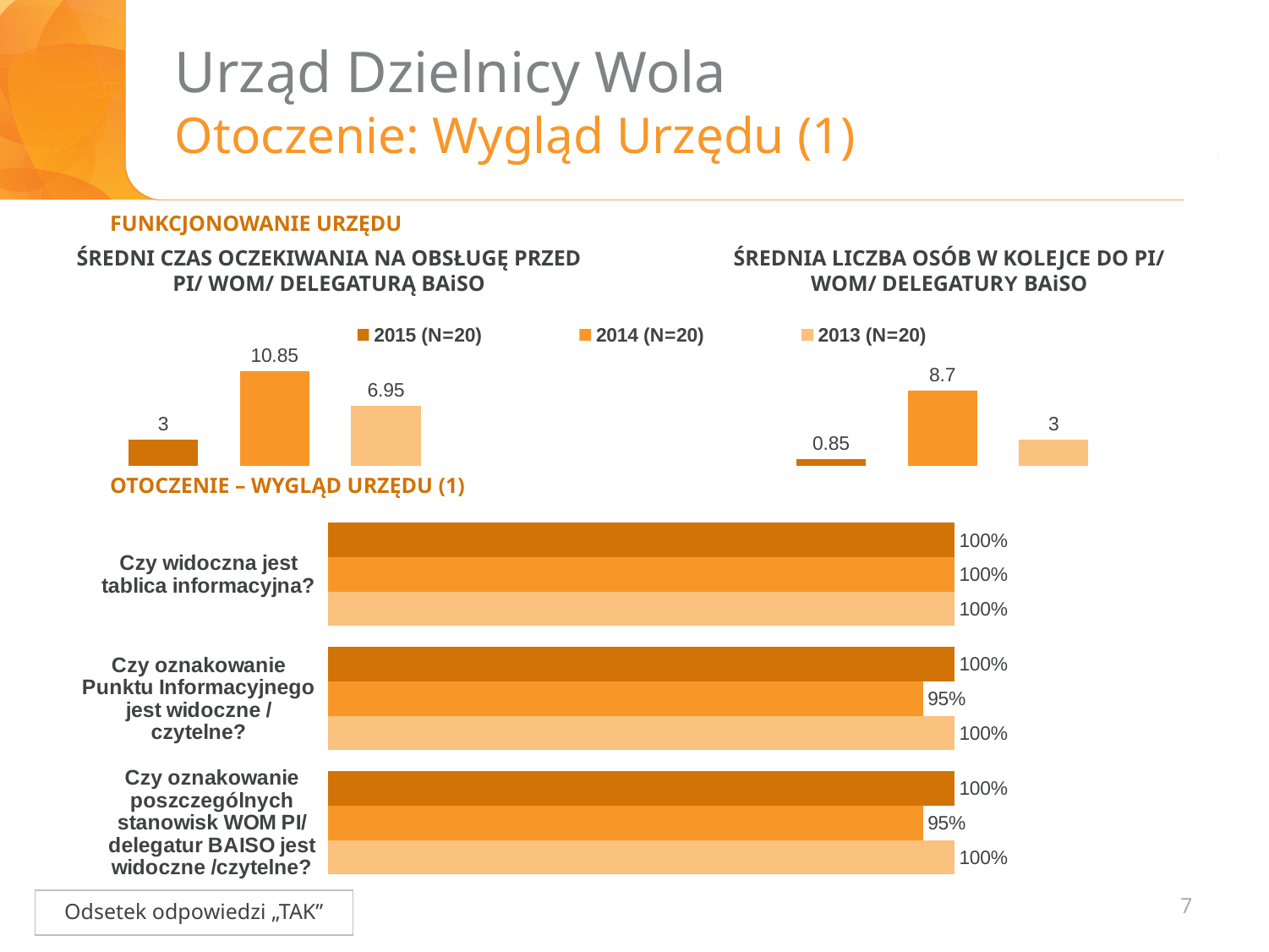
In the chart 'ŚREDNIA LICZBA OSÓB W KOLEJCE DO PI/ WOM/ DELEGATURY BAiSO', which is larger: the value for 2014 or the value for 2013? 2014 In the chart 'ŚREDNIA LICZBA OSÓB W KOLEJCE DO PI/ WOM/ DELEGATURY BAiSO', what is the value for 2014 (N=20)? 8.7 In the chart 'OTOCZENIE – WYGLĄD URZĘDU (1)', what is the 2013 value for 'Czy widoczna jest tablica informacyjna?'? 100% In the chart 'ŚREDNIA LICZBA OSÓB W KOLEJCE DO PI/ WOM/ DELEGATURY BAiSO', which year has the lowest value? 2015 (N=20) In the chart 'ŚREDNI CZAS OCZEKIWANIA NA OBSŁUGĘ PRZED PI/ WOM/ DELEGATURĄ BAiSO', what is the value for 2014 (N=20)? 10.85 What kind of chart is 'OTOCZENIE – WYGLĄD URZĘDU (1)'? Bar chart In the chart 'ŚREDNIA LICZBA OSÓB W KOLEJCE DO PI/ WOM/ DELEGATURY BAiSO', what is the value for 2015 (N=20)? 0.85 In the chart 'OTOCZENIE – WYGLĄD URZĘDU (1)', what is the 2014 value for 'Czy oznakowanie Punktu Informacyjnego jest widoczne / czytelne?'? 95% How many series does the legend at the top of the slide list? 3 In the chart 'ŚREDNI CZAS OCZEKIWANIA NA OBSŁUGĘ PRZED PI/ WOM/ DELEGATURĄ BAiSO', which year has the highest value? 2014 (N=20) In the chart 'ŚREDNI CZAS OCZEKIWANIA NA OBSŁUGĘ PRZED PI/ WOM/ DELEGATURĄ BAiSO', what is the difference between the 2014 and 2013 values? 3.9 In the chart 'ŚREDNI CZAS OCZEKIWANIA NA OBSŁUGĘ PRZED PI/ WOM/ DELEGATURĄ BAiSO', what is the value for 2015 (N=20)? 3